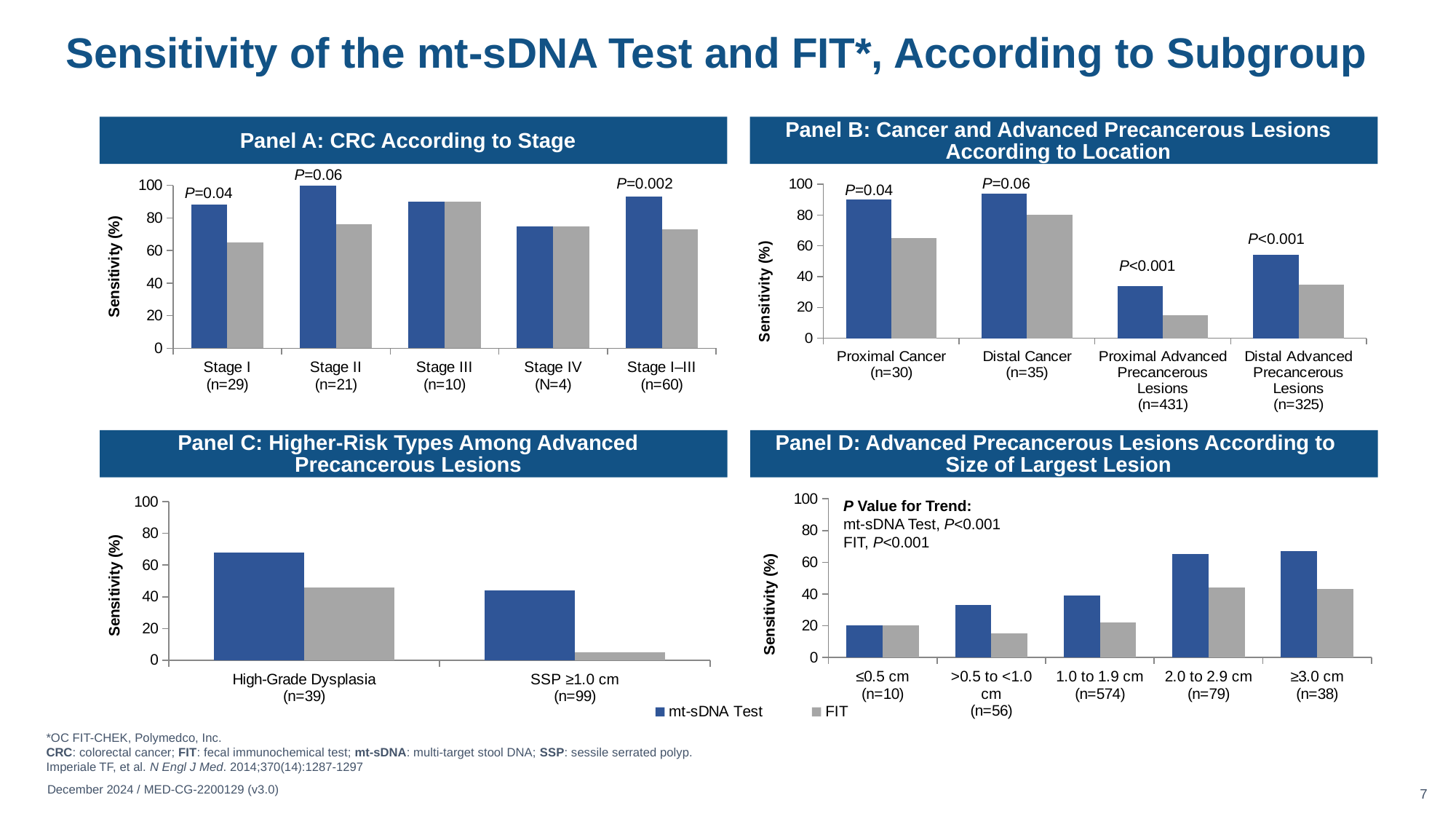
In Panel A: CRC According to Stage, which test has the higher sensitivity for Stage II (n=21), mt-sDNA Test or FIT? mt-sDNA Test How many series does the legend at the bottom of the slide list? 2 In Panel B: Cancer and Advanced Precancerous Lesions According to Location, how many location categories are plotted? 4 In Panel B: Cancer and Advanced Precancerous Lesions According to Location, which category has the lowest mt-sDNA Test sensitivity? Proximal Advanced Precancerous Lesions (n=431) In Panel A: CRC According to Stage, is the FIT sensitivity for Stage I (n=29) greater or less than 80? less In Panel D: Advanced Precancerous Lesions According to Size of Largest Lesion, does the mt-sDNA Test sensitivity rise or fall as lesion size increases along the x axis? rise In Panel A: CRC According to Stage, how many stage categories are shown on the x axis? 5 In Panel A: CRC According to Stage, what P value is shown above the Stage I–III (n=60) bars? P=0.002 In Panel D: Advanced Precancerous Lesions According to Size of Largest Lesion, is the mt-sDNA Test sensitivity for ≥3.0 cm (n=38) greater or less than 60? greater In Panel C: Higher-Risk Types Among Advanced Precancerous Lesions, which test has the higher sensitivity for SSP ≥1.0 cm (n=99)? mt-sDNA Test What kind of chart is Panel C: Higher-Risk Types Among Advanced Precancerous Lesions? bar chart In Panel B: Cancer and Advanced Precancerous Lesions According to Location, is the FIT sensitivity for Proximal Advanced Precancerous Lesions greater or less than 20? less